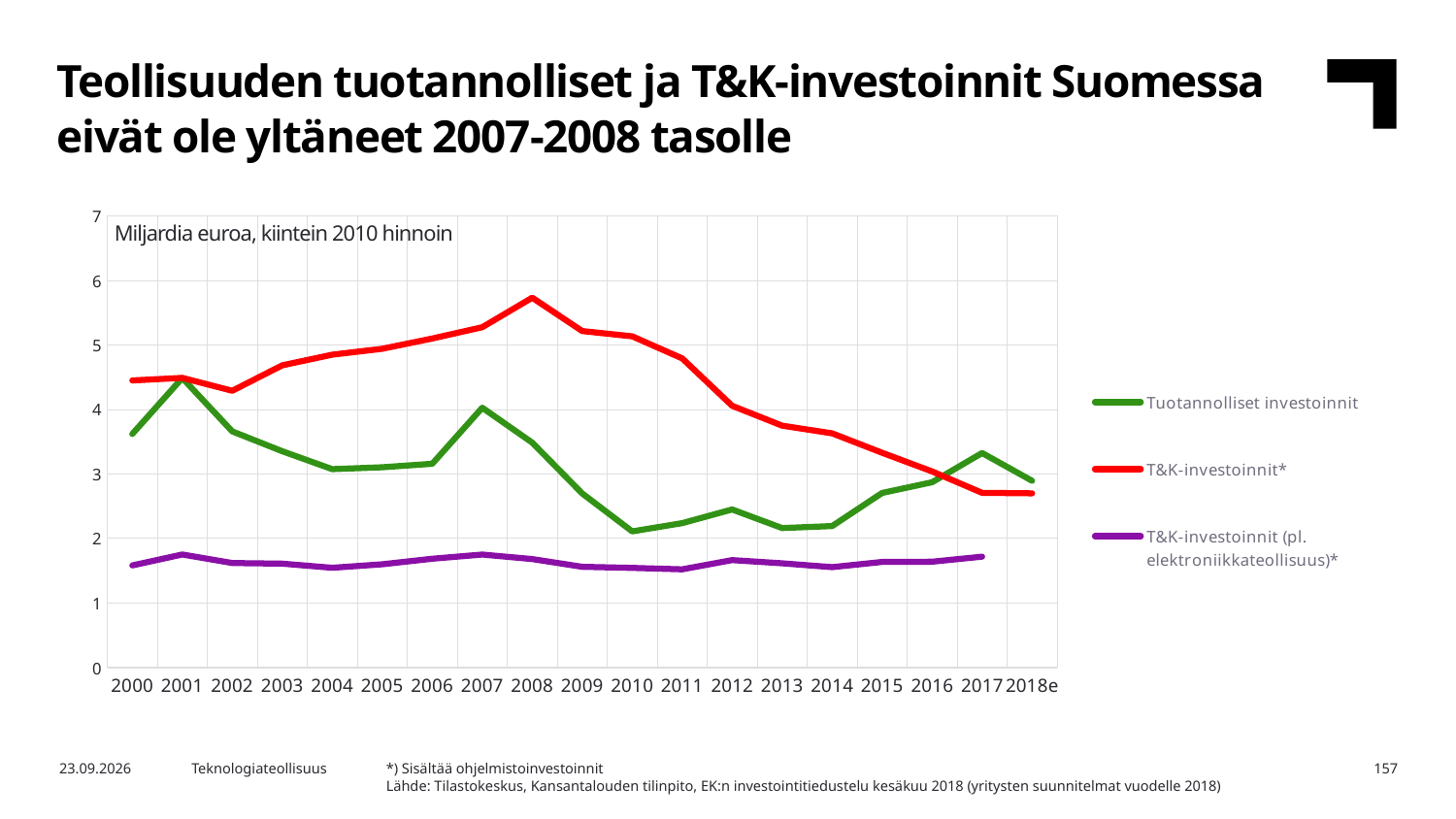
How many years are shown on the x axis? 19 What unit label is shown inside the chart area? Miljardia euroa, kiintein 2010 hinnoin What kind of chart is shown on the slide? Line chart Which series has the higher value in 2017, Tuotannolliset investoinnit or T&K-investoinnit*? Tuotannolliset investoinnit Is the value for Tuotannolliset investoinnit in 2010 greater or less than 3? less In which year does the Tuotannolliset investoinnit series reach its highest value? 2001 Which series has the higher value in 2000, Tuotannolliset investoinnit or T&K-investoinnit*? T&K-investoinnit* In which year does the T&K-investoinnit* series reach its highest value? 2008 How many series does the legend list? 3 Is the value for T&K-investoinnit (pl. elektroniikkateollisuus)* in 2000 greater or less than 2? less Does the T&K-investoinnit* series rise or fall from 2008 to 2017? fall Is the value for T&K-investoinnit* in 2008 greater or less than 5? greater